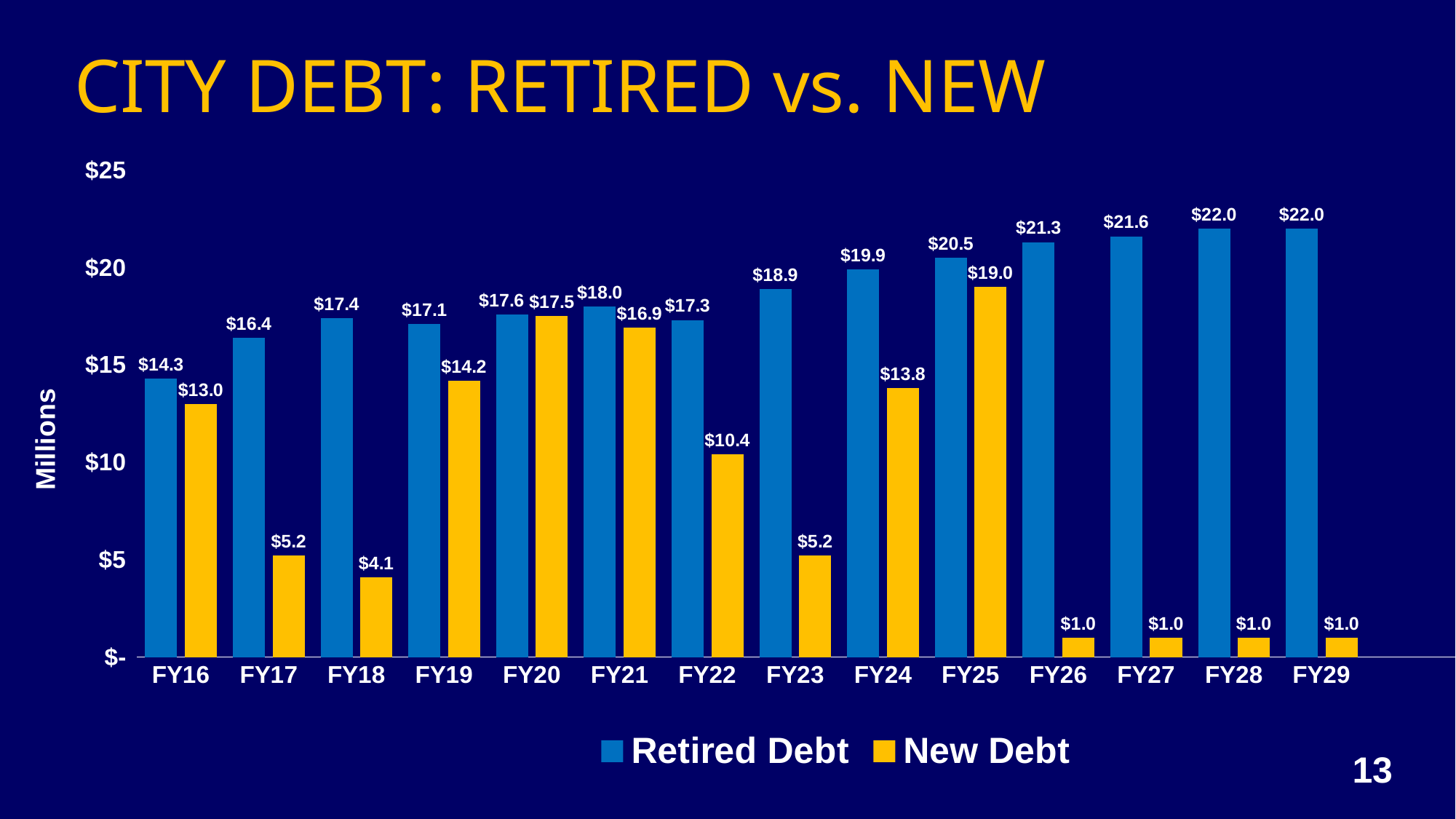
How many series does the legend list? 2 Which fiscal year has the highest New Debt value? FY25 What is the New Debt value for FY22? $10.4 What kind of chart is shown on the slide? Bar chart What is the New Debt value for FY25? $19.0 Which is larger in FY20, Retired Debt or New Debt? Retired Debt Does the Retired Debt series rise or fall from FY16 to FY29? Rise What is the Retired Debt value for FY18? $17.4 Which fiscal year has the lowest Retired Debt value? FY16 Is the Retired Debt value for FY26 greater or less than $20? greater What is the difference between Retired Debt and New Debt in FY23? $13.7 How many fiscal years are shown on the x axis? 14